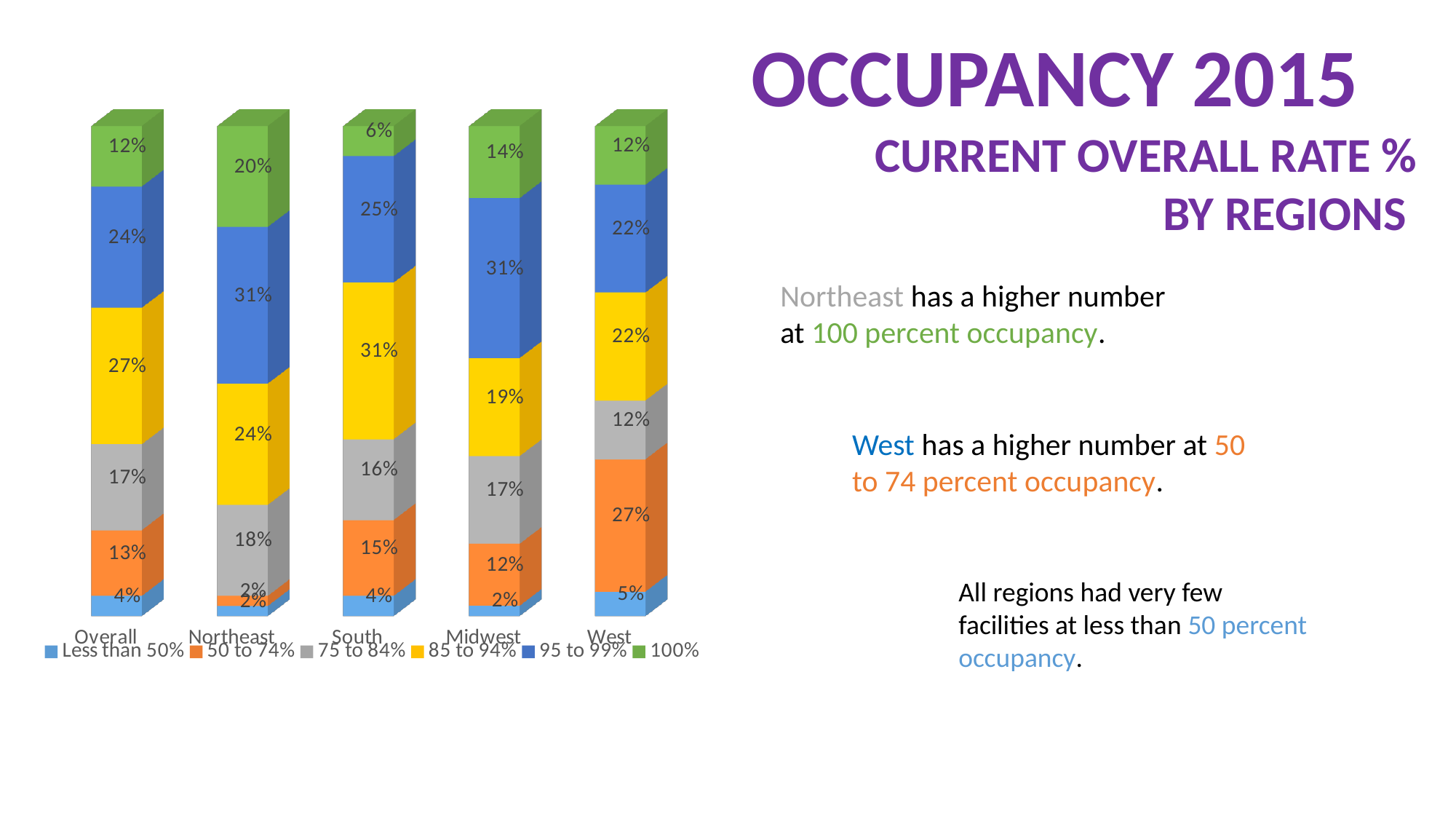
What kind of chart is shown on the slide? Stacked bar chart How many series does the chart legend list? 6 What is the value for the 100% series in the Northeast bar? 20% What is the value for the 50 to 74% series in the West bar? 27% How many regions (categories) are shown on the x axis of the chart? 5 What is the difference between the 50 to 74% values for West and Midwest? 15% Which region has the lowest value for the 100% series? South Which region has the highest value for the 100% series? Northeast What is the title of the chart on the slide? Occupancy 2015 Current Overall Rate % by Regions What is the value for the 95 to 99% series in the Midwest bar? 31% What is the value for the 85 to 94% series in the South bar? 31% Which is larger: the 75 to 84% value for Northeast or for West? Northeast